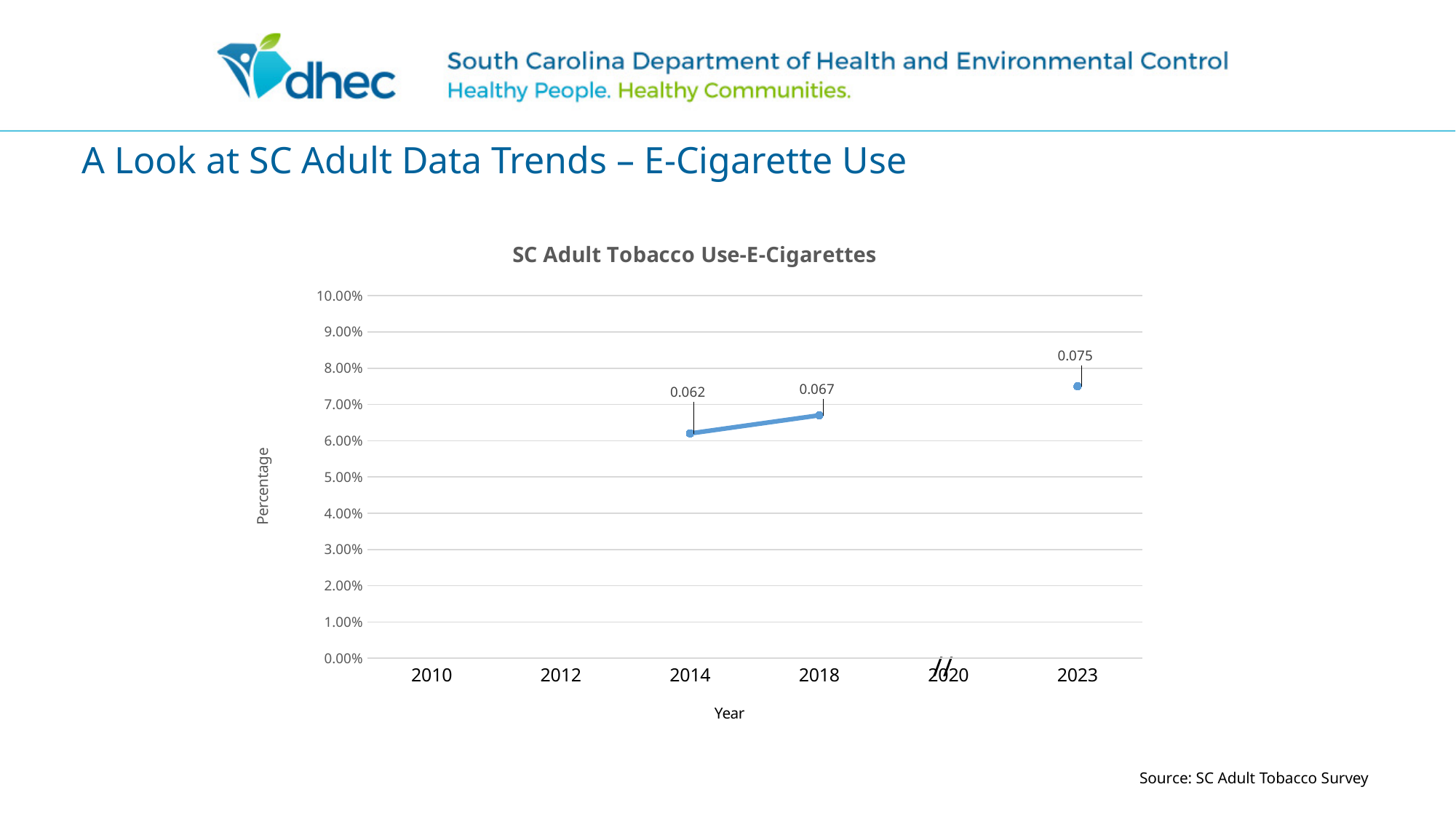
Which year has the lowest plotted e-cigarette use value in the chart? 2014 What is the data label shown for 2018 in the SC Adult Tobacco Use-E-Cigarettes chart? 0.067 What is the data label shown for 2023 in the SC Adult Tobacco Use-E-Cigarettes chart? 0.075 What is the data label shown for 2014 in the SC Adult Tobacco Use-E-Cigarettes chart? 0.062 What is the difference between the 2023 and 2014 data labels in the chart? 0.013 How many data points are plotted in the SC Adult Tobacco Use-E-Cigarettes chart? 3 What is the title of the chart on the slide? SC Adult Tobacco Use-E-Cigarettes Is the value for 2023 greater or less than 7.00% on the y axis? greater Which year has the highest e-cigarette use value in the chart? 2023 Do the plotted e-cigarette use values rise or fall from 2014 to 2023? Rise What kind of chart is shown on the slide? Line chart Which is larger, the value for 2018 or the value for 2014? 2018